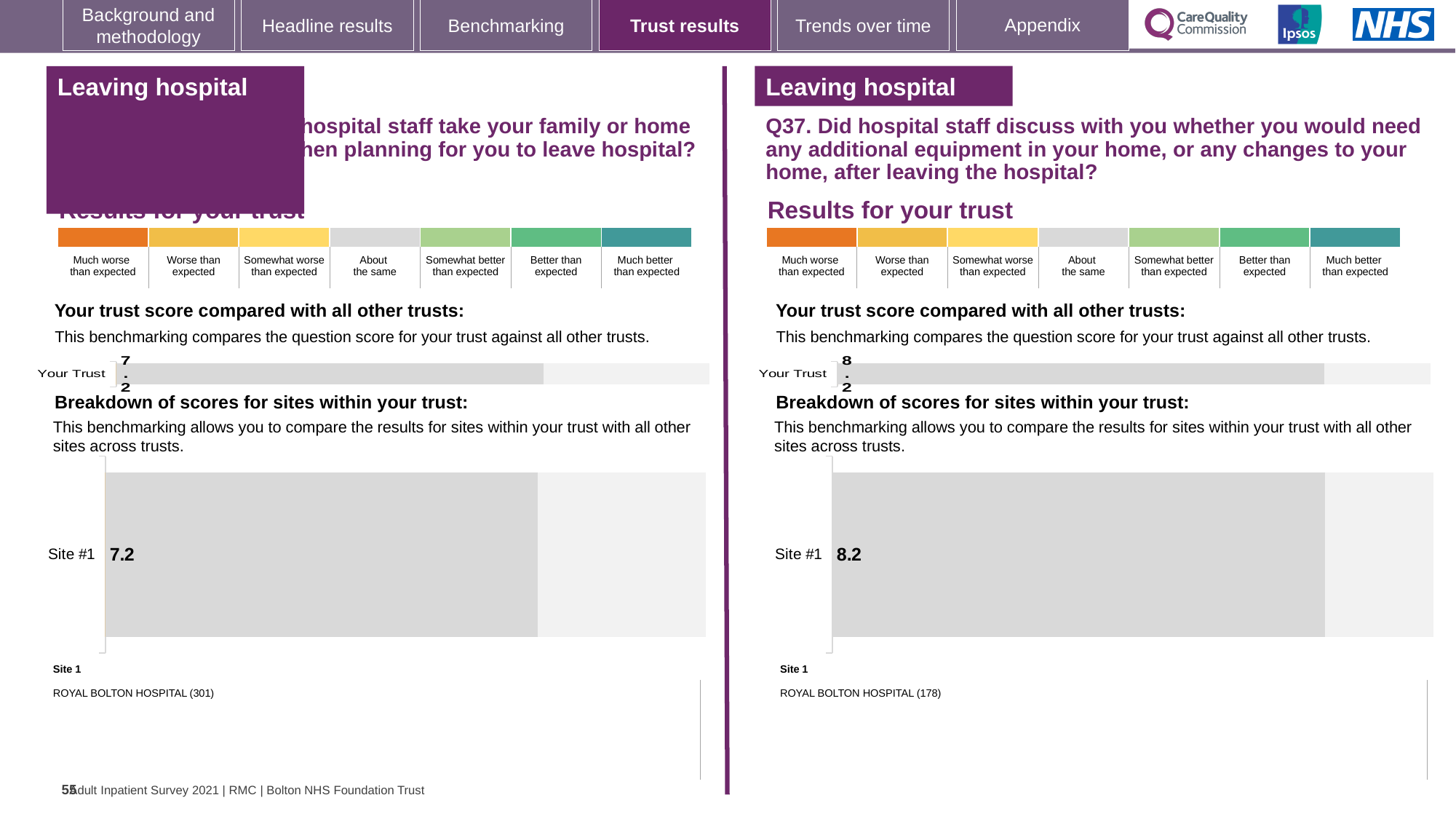
What is the difference between the Site #1 score on the right-hand chart for Q37 and the Site #1 score on the left-hand chart? 1.0 On the right-hand panel for Q37, what is the 'Your Trust' score shown in the trust comparison bar? 8.2 On the right-hand panel for Q37, which hospital is listed as Site 1? ROYAL BOLTON HOSPITAL (178) How many sites are shown in the site breakdown chart on the right-hand panel for Q37? 1 On the left-hand chart, what is the score shown for Site #1? 7.2 What type of chart is used for the site breakdown on the right-hand panel for Q37? Bar chart On the right-hand chart for Q37, what is the score shown for Site #1? 8.2 On the left-hand panel, what is the 'Your Trust' score shown in the trust comparison bar? 7.2 On the left-hand panel, which hospital is listed as Site 1? ROYAL BOLTON HOSPITAL (301) Which is larger: the Site #1 score on the left-hand chart or the Site #1 score on the right-hand chart for Q37? The right-hand chart (Q37) How many sites are shown in the site breakdown chart on the left-hand panel? 1